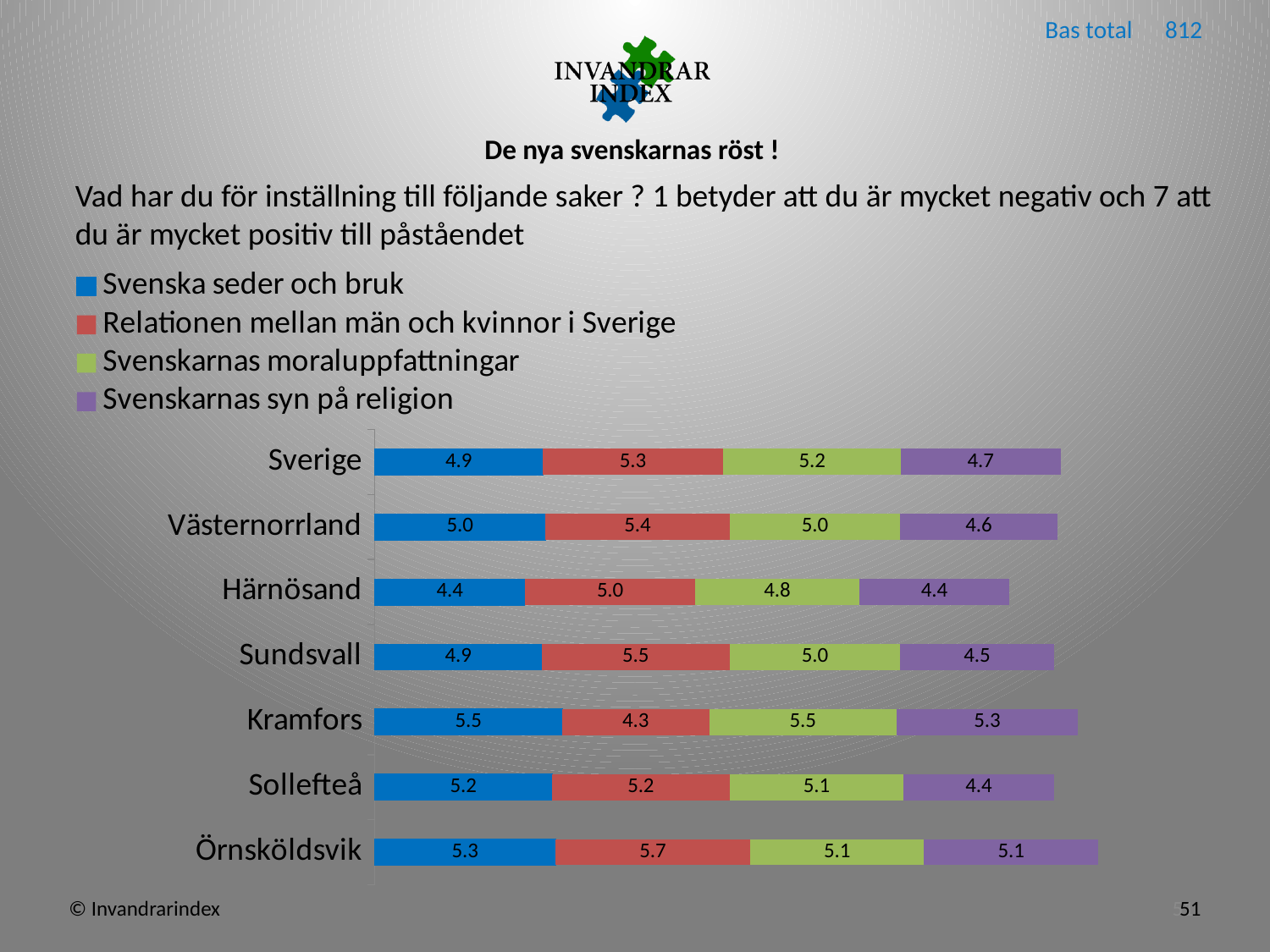
Which category has the lowest value for Svenska seder och bruk? Härnösand What is the value for Svenska seder och bruk for Sverige? 4.9 How many categories are shown on the chart? 7 What is the value for Svenskarnas syn på religion for Kramfors? 5.3 Which has the larger value for Svenska seder och bruk, Kramfors or Härnösand? Kramfors Which category has the lowest value for Relationen mellan män och kvinnor i Sverige? Kramfors What is the difference between the Relationen mellan män och kvinnor i Sverige values for Örnsköldsvik and Kramfors? 1.4 What is the total of the stacked bar for Härnösand? 18.6 How many series does the legend list? 4 What is the value for Relationen mellan män och kvinnor i Sverige for Örnsköldsvik? 5.7 Which category has the highest value for Relationen mellan män och kvinnor i Sverige? Örnsköldsvik What is the value for Svenskarnas moraluppfattningar for Härnösand? 4.8